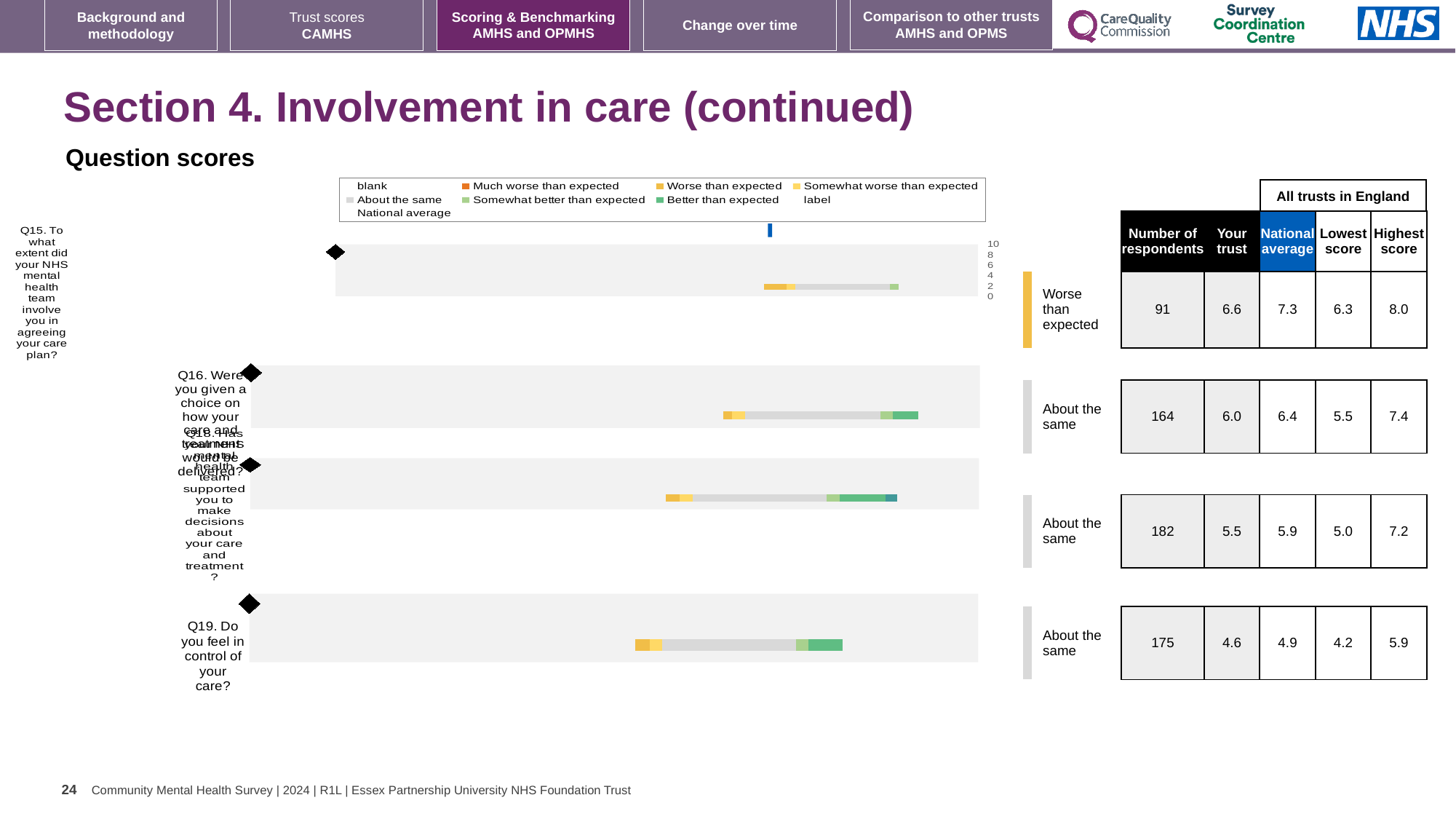
What is the national average score for Q19 (Do you feel in control of your care)? 4.9 For Q16, which is larger: the 'Your trust' score or the national average? National average What is the 'Your trust' score for Q15 (involving you in agreeing your care plan)? 6.6 What is the difference between the highest and lowest scores for Q19? 1.7 What is the difference between the national average and the 'Your trust' score for Q15? 0.7 What benchmark category is shown for Q15? Worse than expected Which question has the highest 'Your trust' score? Q15 What is the highest score among all trusts in England for Q16? 7.4 Which question has the lowest 'Your trust' score? Q19 How many respondents answered Q18 (supported you to make decisions about your care and treatment)? 182 How many questions (categories) are plotted in the question scores chart? 4 What kind of chart is used to show the question scores on this slide? bar chart